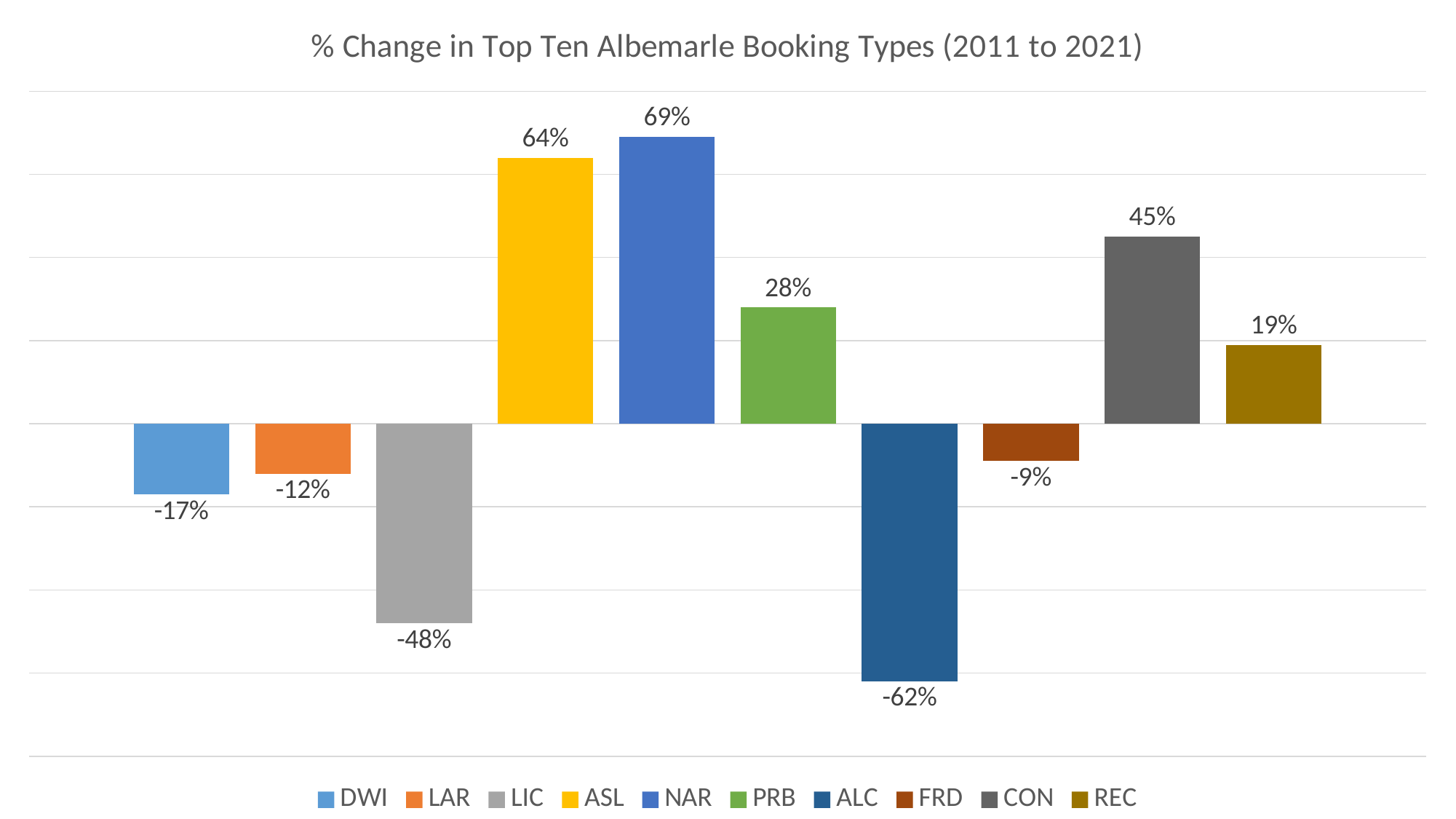
How many entries does the legend list? 10 How many booking types are shown in the chart? 10 Which booking type has the highest % change? NAR What kind of chart is shown on the slide? Bar chart Which booking type has the lowest % change? ALC What is the difference between the % change for ASL and the % change for PRB? 36% Which has a larger % change, CON or REC? CON What is the % change for NAR? 69% What is the title of the chart? % Change in Top Ten Albemarle Booking Types (2011 to 2021) What is the % change for LIC? -48% Which has a larger % change, DWI or LAR? LAR What is the % change for CON? 45%